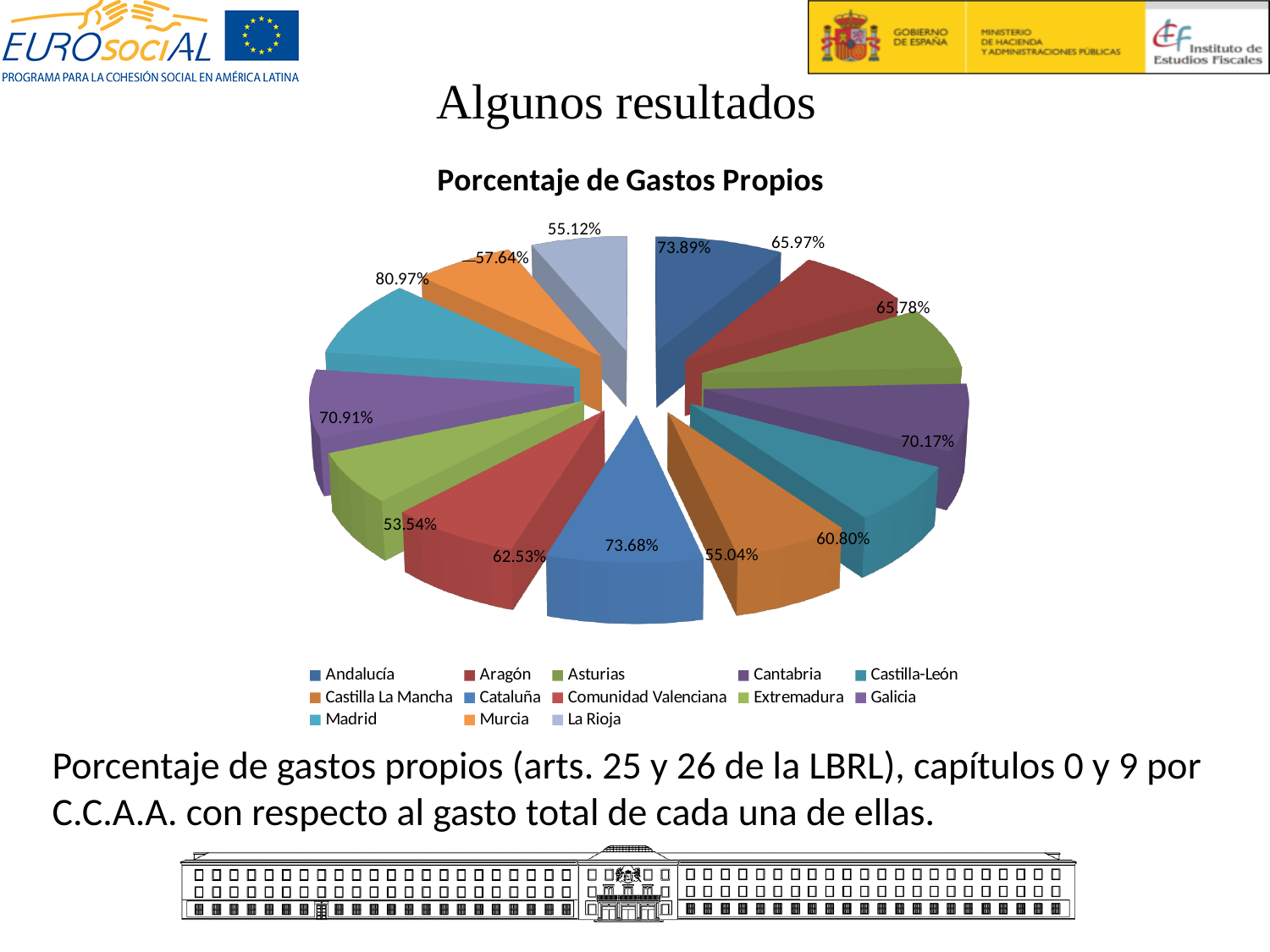
What is the value shown for Extremadura? 53.54% What is the value shown for Andalucía? 73.89% What is the value shown for Madrid? 80.97% What is the title of the chart? Porcentaje de Gastos Propios What kind of chart is shown on the slide? Pie chart What is the difference between the values for Madrid and Extremadura? 27.43% What is the value shown for Castilla-León? 60.80% What is the value shown for Cataluña? 73.68% Which has a larger value, Galicia or Cantabria? Galicia How many regions (slices) does the pie chart show? 13 Which region has the lowest value in the chart? Extremadura Which region has the highest value in the chart? Madrid